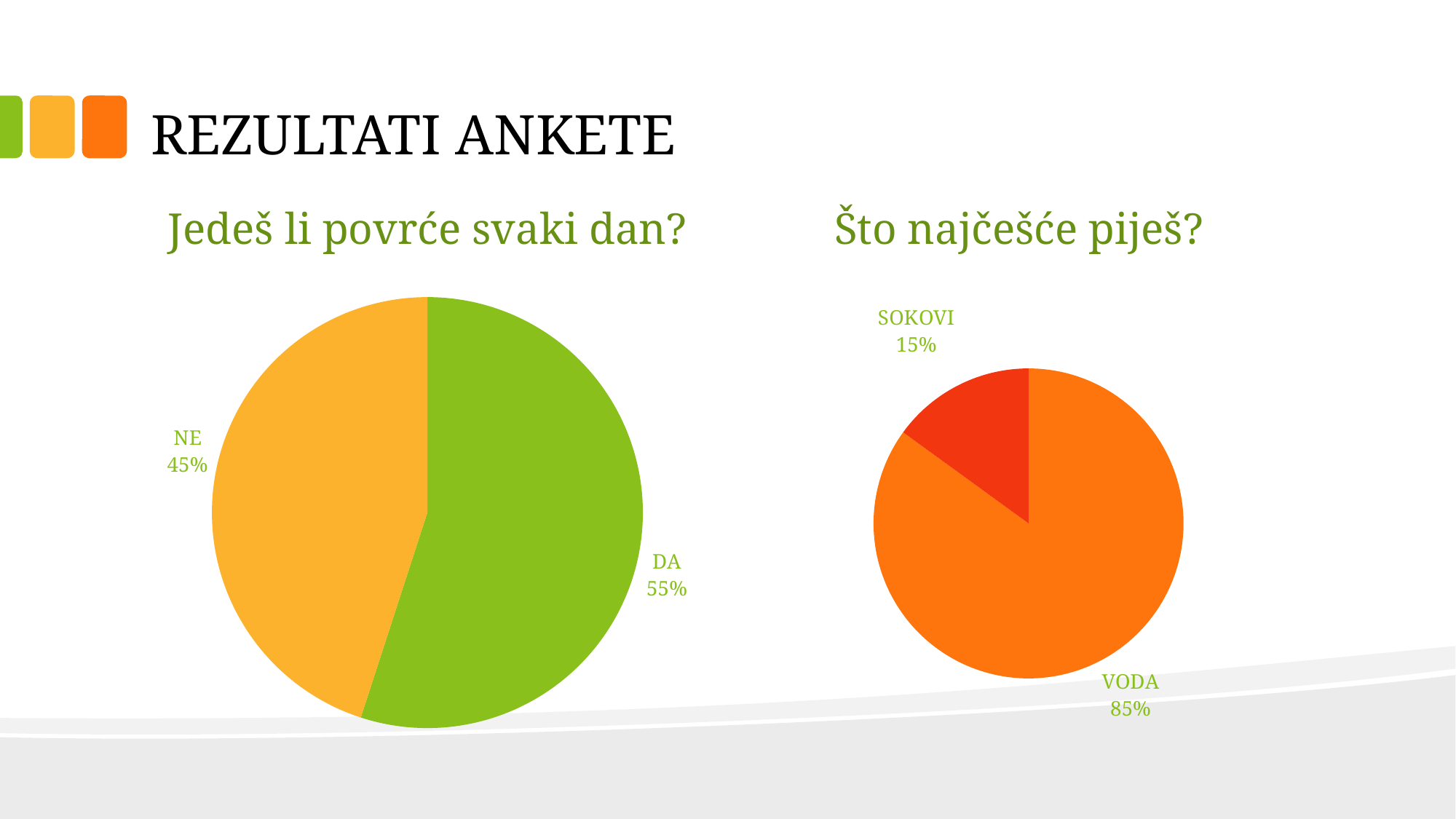
In the chart titled "Što najčešće piješ?", what share of the pie is SOKOVI? 15% In the chart titled "Jedeš li povrće svaki dan?", how many slices does the pie have? 2 In the chart titled "Što najčešće piješ?", which is larger, VODA or SOKOVI? VODA What kind of chart is the chart on the left of the slide? Pie chart In the chart titled "Što najčešće piješ?", what share of the pie is VODA? 85% In the chart titled "Što najčešće piješ?", which slice is the smallest? SOKOVI In the chart titled "Jedeš li povrće svaki dan?", what is the difference between the DA and NE shares? 10% In the chart titled "Jedeš li povrće svaki dan?", what share of the pie is DA? 55% In the chart titled "Jedeš li povrće svaki dan?", what colour is the DA slice? Green In the chart titled "Što najčešće piješ?", what is the difference between the VODA and SOKOVI shares? 70% In the chart titled "Jedeš li povrće svaki dan?", which slice is the largest? DA